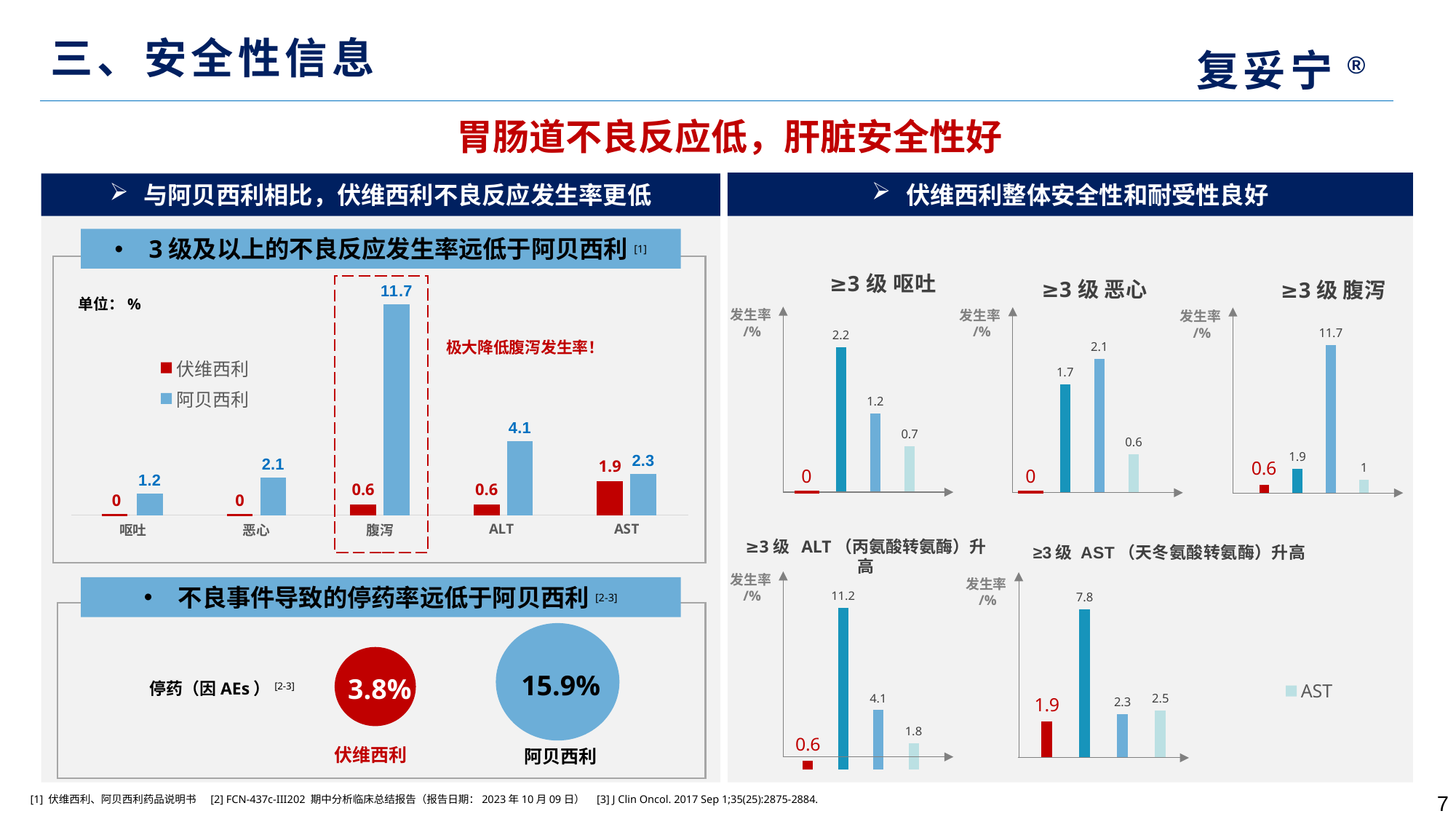
In the left bar chart comparing 伏维西利 and 阿贝西利, what is the value for 伏维西利 in the AST category? 1.9 In the left bar chart comparing 伏维西利 and 阿贝西利, which category has the highest value for 阿贝西利? 腹泻 What type of chart is the chart titled ≥3 级 腹泻 on the right side of the slide? bar chart In the chart titled ≥3 级 呕吐, how many bars are plotted? 4 In the left bar chart comparing 伏维西利 and 阿贝西利, which series is larger in the 恶心 category? 阿贝西利 In the chart titled ≥3 级 ALT（丙氨酸转氨酶）升高, what is the highest value shown? 11.2 In the left bar chart comparing 伏维西利 and 阿贝西利, what is the value for 阿贝西利 in the 腹泻 category? 11.7 In the left bar chart comparing 伏维西利 and 阿贝西利, how many categories are shown on the x axis? 5 In the left bar chart comparing 伏维西利 and 阿贝西利, what is the difference between the 阿贝西利 and 伏维西利 values in the ALT category? 3.5 In the left bar chart comparing 伏维西利 and 阿贝西利, how many series does the legend list? 2 In the left bar chart comparing 伏维西利 and 阿贝西利, what colour represents 伏维西利 in the legend? red In the chart titled ≥3 级 AST（天冬氨酸转氨酶）升高, what is the value of the red bar for 伏维西利? 1.9